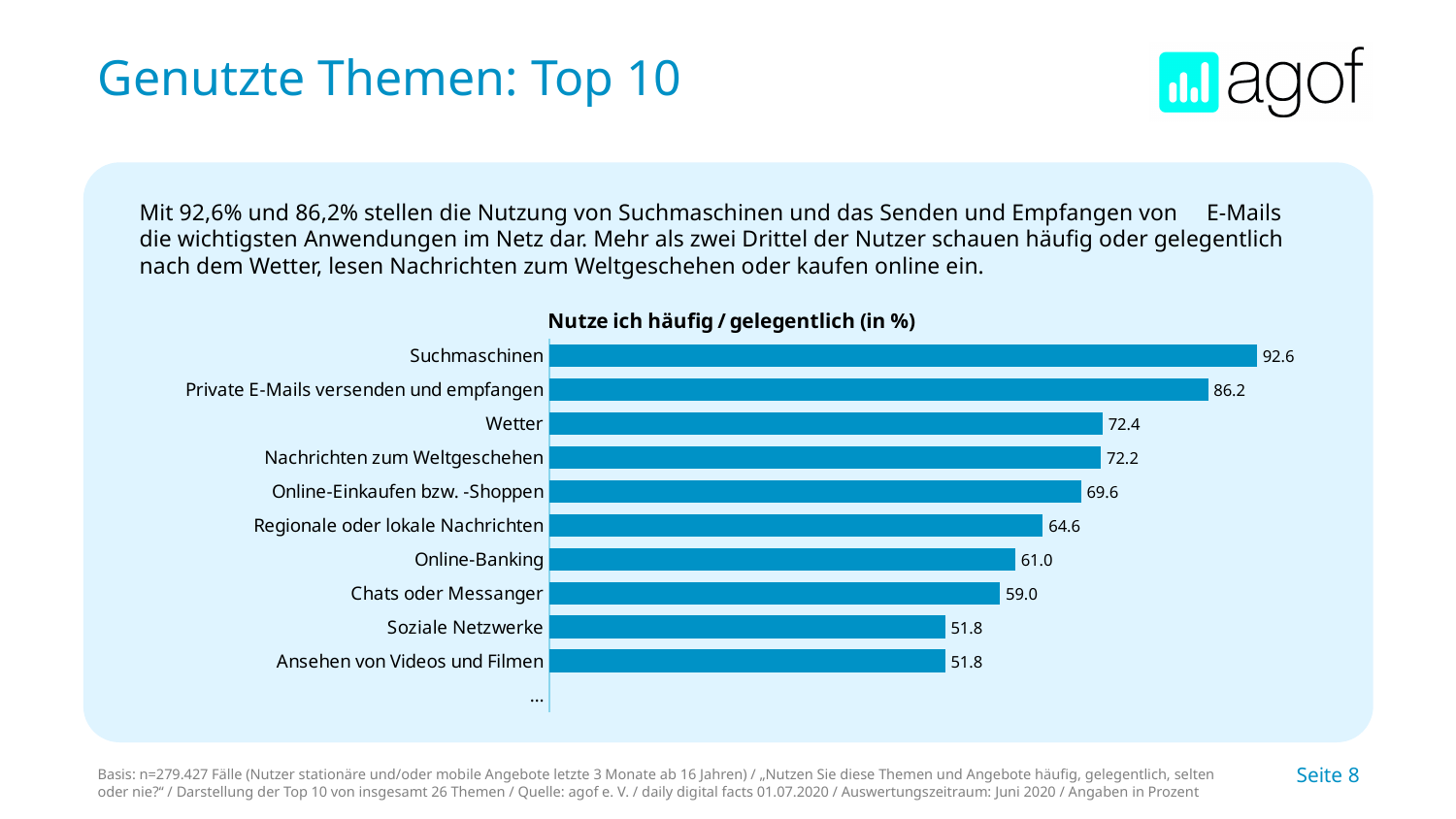
What is the difference between the values for Suchmaschinen and Private E-Mails versenden und empfangen? 6.4 Which is larger, the value for Wetter or the value for Soziale Netzwerke? Wetter Which category has the highest value? Suchmaschinen What is the title of the chart? Nutze ich häufig / gelegentlich (in %) What is the value for Ansehen von Videos und Filmen? 51.8 What kind of chart is shown on the slide? Bar chart What is the difference between the values for Wetter and Online-Einkaufen bzw. -Shoppen? 2.8 What is the value for Online-Banking? 61.0 What is the value for Suchmaschinen? 92.6 Which is larger, the value for Online-Banking or the value for Chats oder Messanger? Online-Banking How many labelled bars are shown in the chart? 10 What is the value for Regionale oder lokale Nachrichten? 64.6